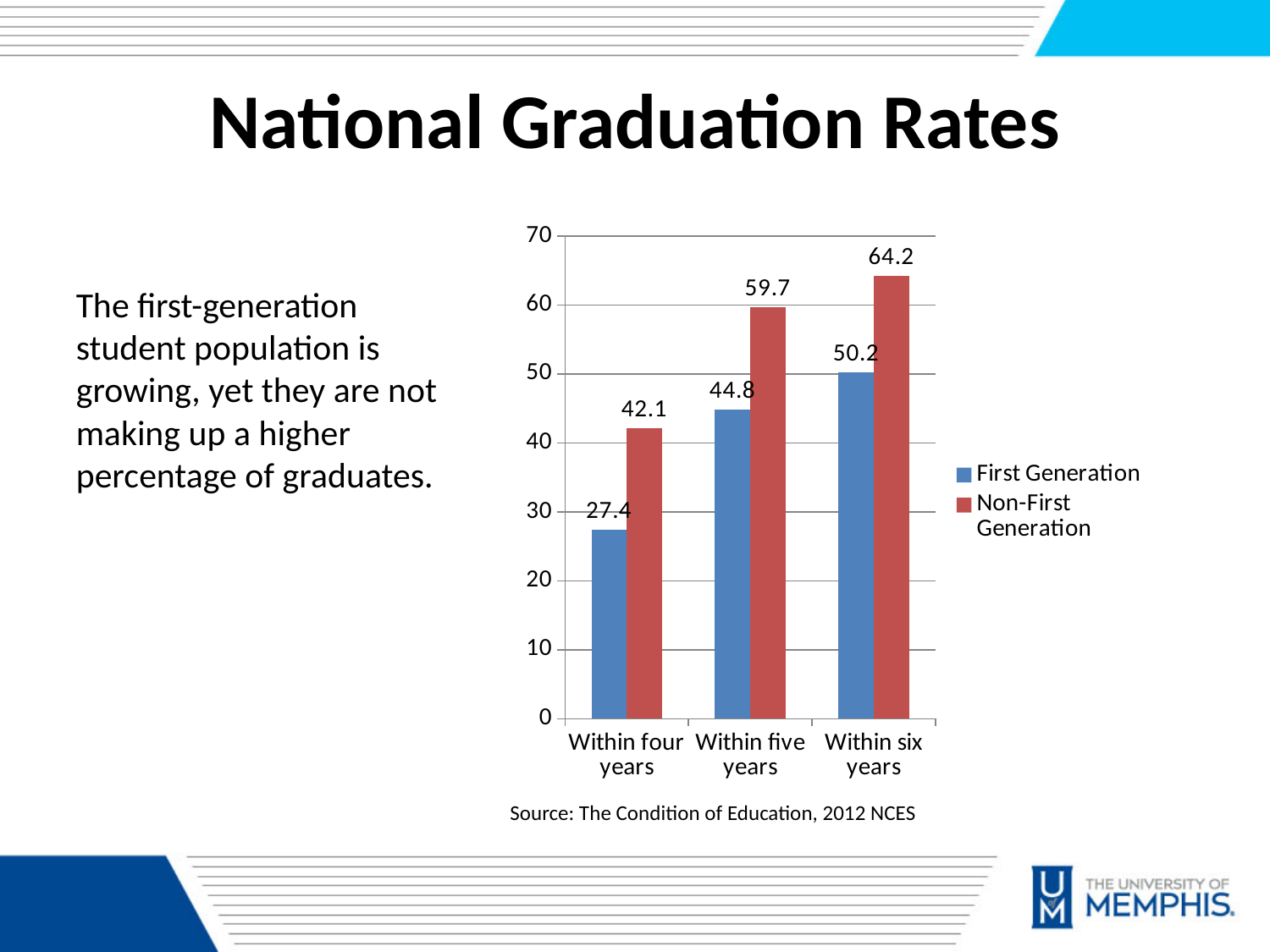
Do the First Generation values rise or fall from 'Within four years' to 'Within six years'? Rise What is the difference between the First Generation values for 'Within six years' and 'Within five years'? 5.4 Which category has the highest First Generation value? Within six years What is the difference between the Non-First Generation and First Generation values within four years? 14.7 What kind of chart is shown on the slide? Bar chart What is the Non-First Generation value for 'Within five years'? 59.7 What is the First Generation graduation rate within four years? 27.4 How many series does the legend list? 2 What is the Non-First Generation graduation rate within six years? 64.2 Which category has the lowest Non-First Generation value? Within four years Which is larger: the First Generation value within six years or the Non-First Generation value within four years? First Generation within six years How many categories are shown on the x axis? 3